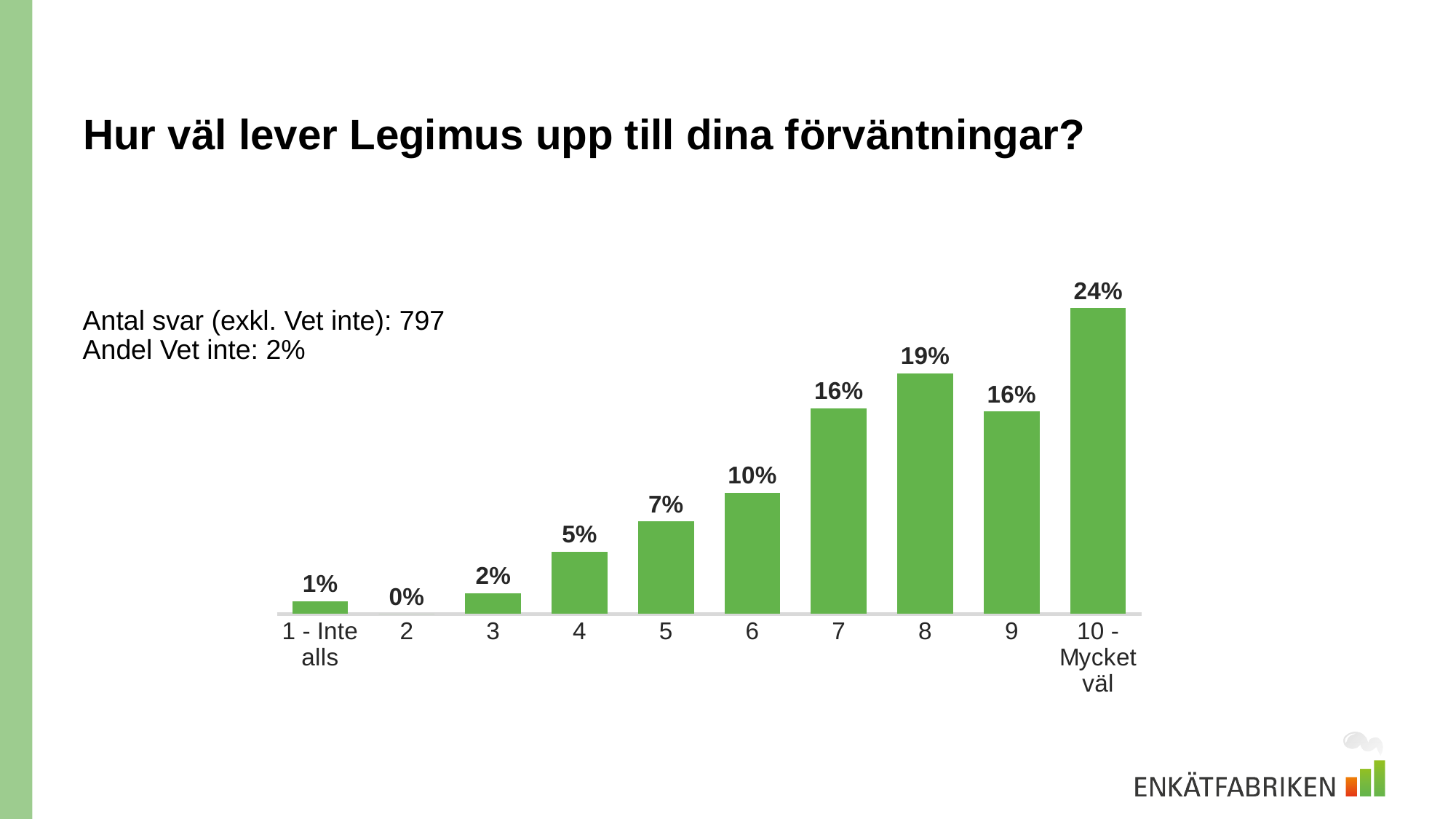
Which is larger, the value for category 4 or the value for category 6? 6 Which category has the lowest value? 2 What is the value for category 8? 19% What is the value for category "10 - Mycket väl"? 24% What kind of chart is shown on the slide? Bar chart Which category has the highest value? 10 - Mycket väl What is the difference between the values for category 8 and category 6? 9% How many categories are shown on the x axis? 10 What is the value for category 5? 7% What is the number of responses (Antal svar, exkl. Vet inte) stated on the slide? 797 What is the difference between the values for "10 - Mycket väl" and category 9? 8% What is the value for category "1 - Inte alls"? 1%